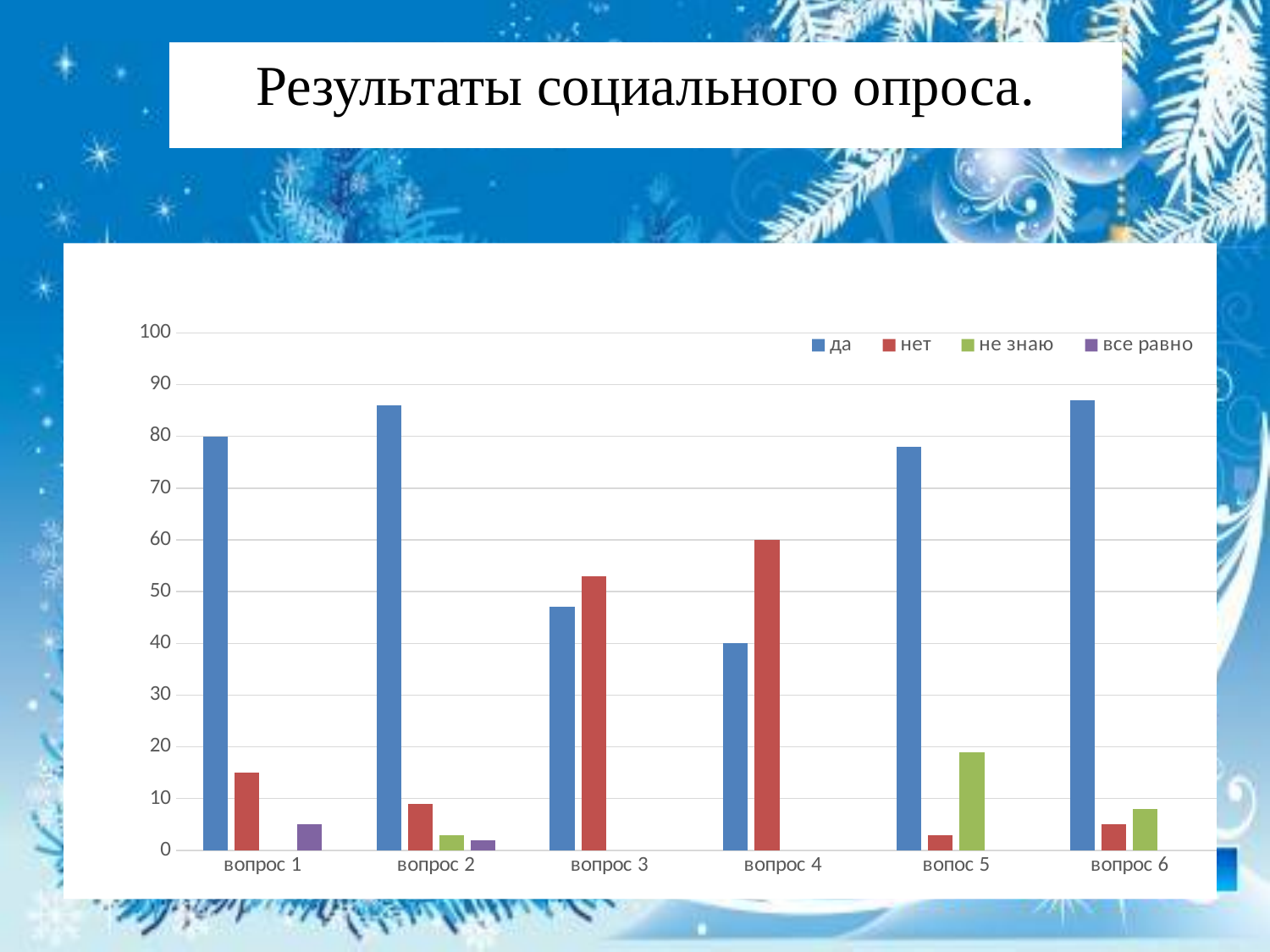
For вопрос 4, what is the difference between "нет" and "да"? 20 What kind of chart is shown on the slide? bar chart Which question has the lowest value for "да"? вопрос 4 Is the value of "да" for вопрос 2 greater or less than 80? greater What is the value of "да" for вопрос 4? 40 For вопрос 3, which is larger, "да" or "нет"? нет How many question categories are shown on the x axis? 6 What is the value of "да" for вопрос 1? 80 How many series does the legend list? 4 What is the value of "нет" for вопрос 4? 60 Which question has the highest value for "нет"? вопрос 4